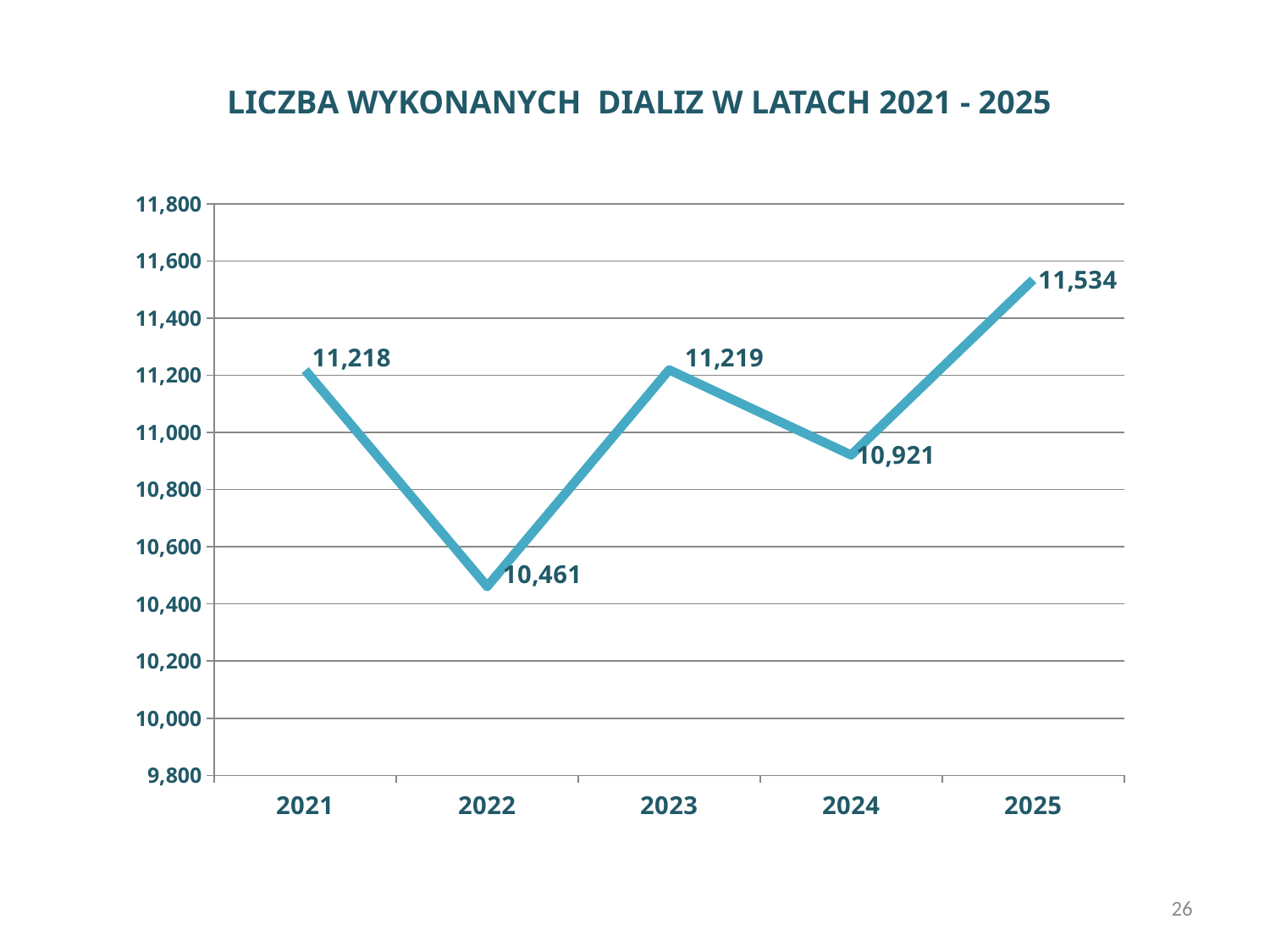
What kind of chart is shown on the slide? line chart How many years are plotted on the chart? 5 What is the title of the chart? LICZBA WYKONANYCH DIALIZ W LATACH 2021 - 2025 Which year has the highest number of dialyses? 2025 Which is larger, the value for 2023 or the value for 2024? 2023 What is the value for 2024? 10,921 Which year has the lowest number of dialyses? 2022 What is the difference between the values for 2021 and 2022? 757 What is the value for 2022? 10,461 What is the value for 2025? 11,534 What is the number of dialyses performed in 2021? 11,218 What is the difference between the values for 2025 and 2024? 613